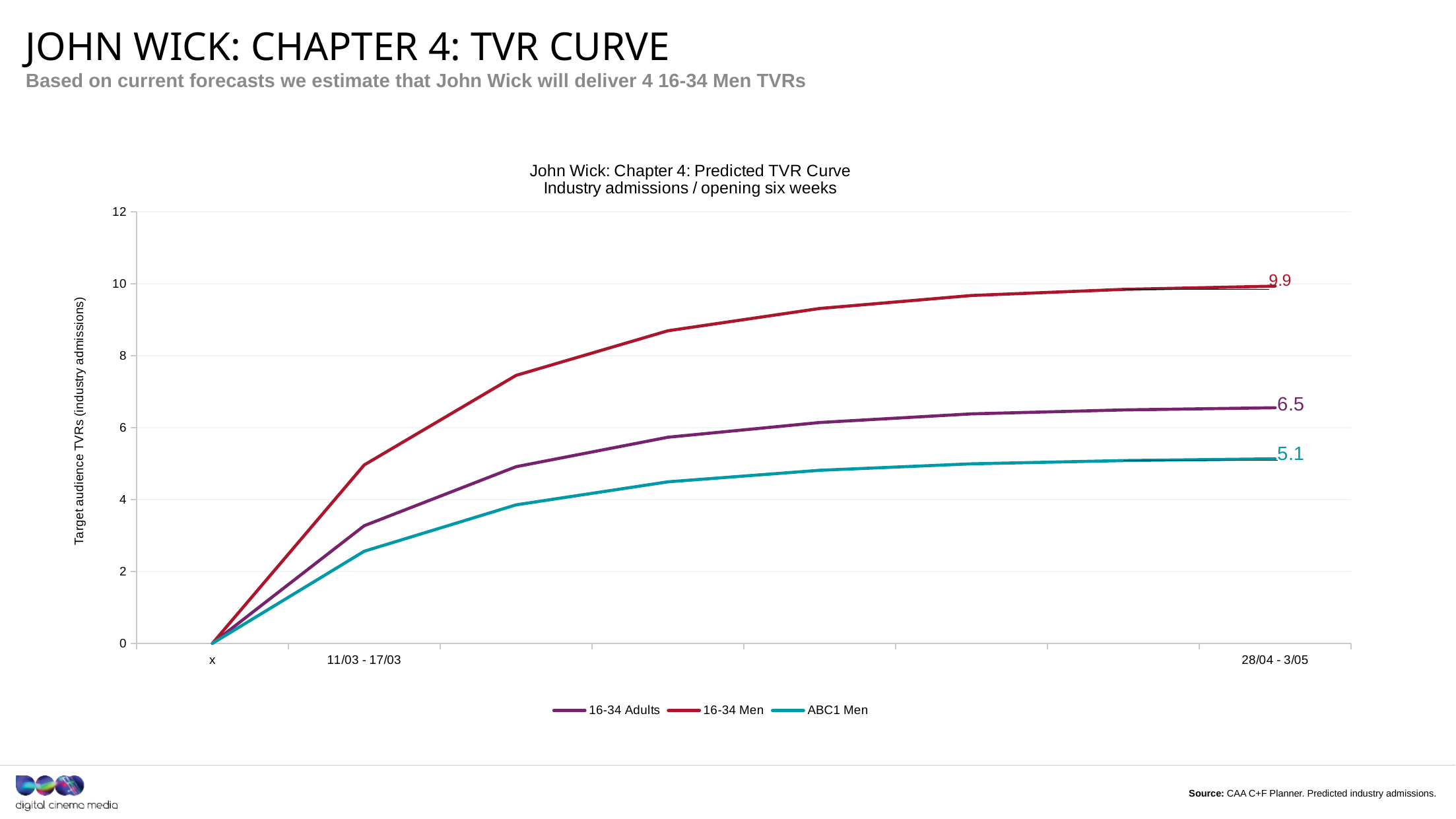
What is the difference between the final values of 16-34 Adults and ABC1 Men? 1.4 What kind of chart is shown on the slide? line chart Which series has the lowest final value? ABC1 Men Which series reaches the highest final value? 16-34 Men What is the final value shown for the 16-34 Adults series? 6.5 How many series does the legend list? 3 Do the values rise or fall along the x axis? rise Is the value for 16-34 Men at 11/03 - 17/03 greater or less than 4? greater What is the difference between the final values of 16-34 Men and ABC1 Men? 4.8 What is the final value shown for the ABC1 Men series? 5.1 What is the final value shown for the 16-34 Men series? 9.9 Which is larger at the end of the period: the 16-34 Adults value or the ABC1 Men value? 16-34 Adults